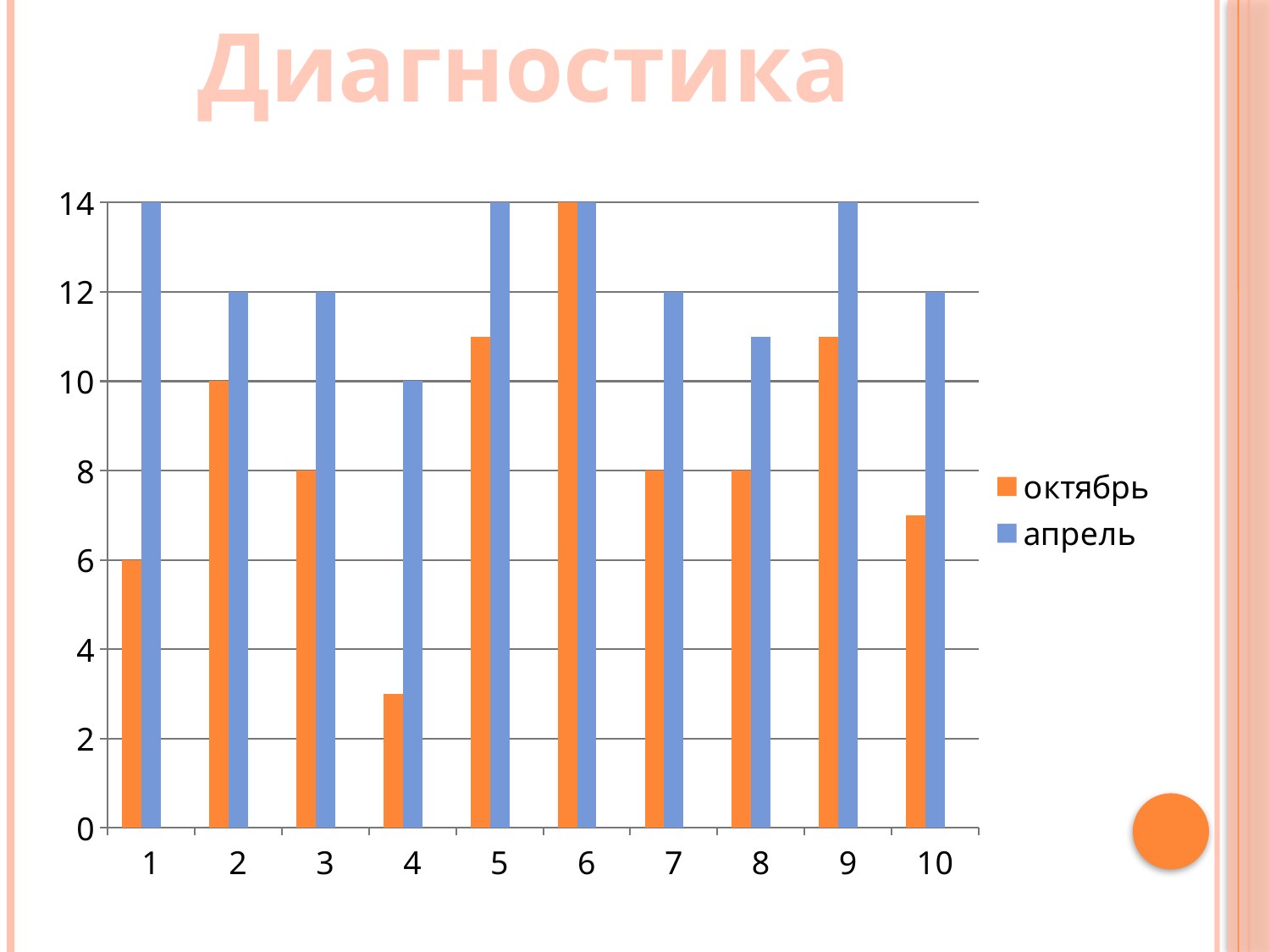
Which category has the lowest value for октябрь? 4 What kind of chart is shown on the slide? bar chart What is the difference between апрель and октябрь at category 1? 8 Is the value for октябрь at category 4 greater or less than 4? less How many categories are shown on the x axis? 10 What is the value for октябрь at category 2? 10 What is the value for октябрь at category 1? 6 What is the value for апрель at category 4? 10 Is the value for апрель at category 8 greater or less than 10? greater How many series does the legend list? 2 Which is larger at category 7, октябрь or апрель? апрель What is the value for апрель at category 10? 12